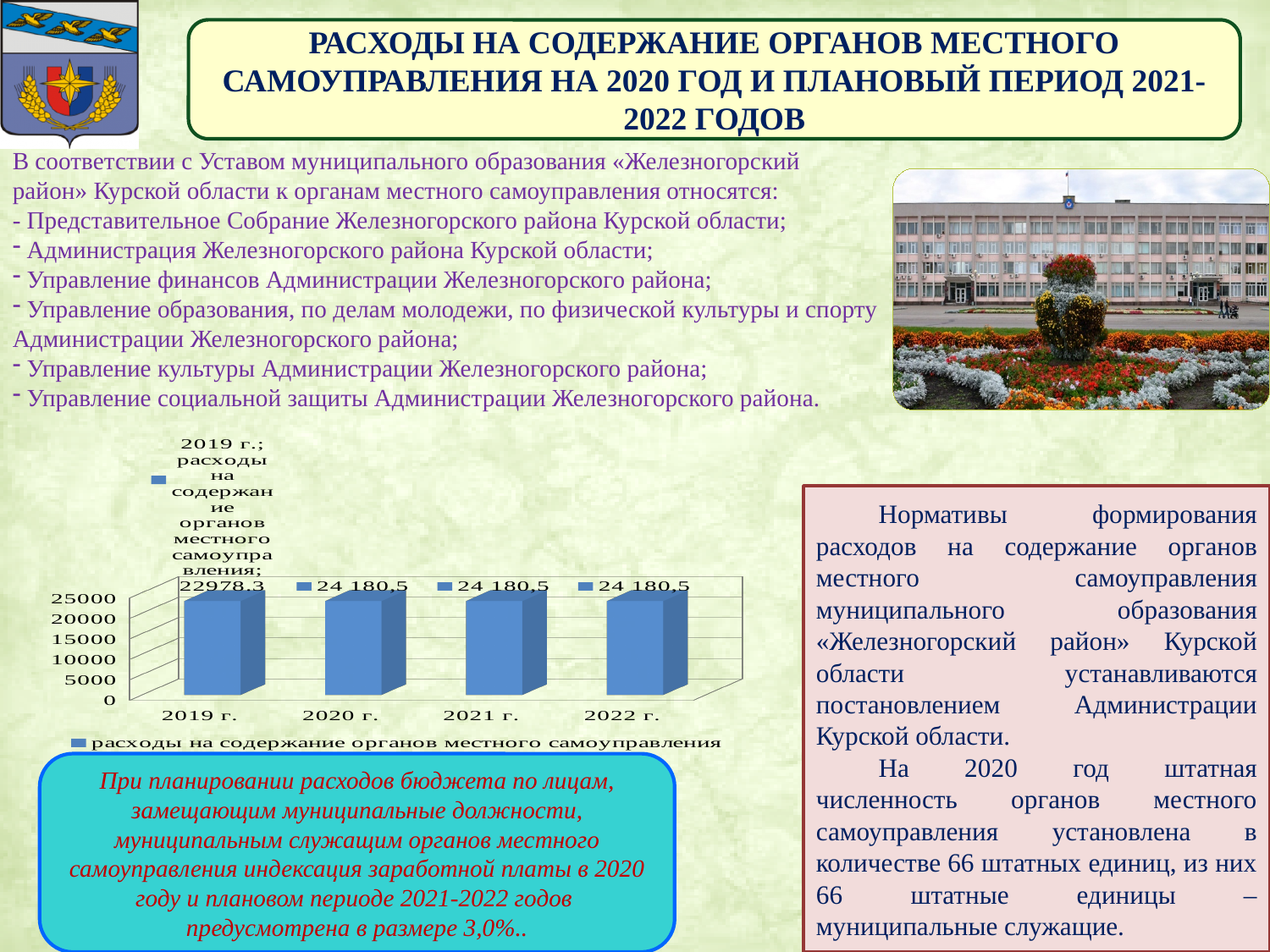
Which year has the lowest value in the chart? 2019 г. Do the values change between 2020 г. and 2022 г.? No, they stay the same What is the difference between the values for 2020 г. and 2019 г.? 1202,2 How many years are shown on the x axis of the chart? 4 What is the value for 2020 г. in the chart? 24 180,5 What is the value for 2022 г. in the chart? 24 180,5 What is the value for 2019 г. in the chart? 22978,3 What is the legend entry of the chart? расходы на содержание органов местного самоуправления What kind of chart is shown on the slide? bar chart How many series does the chart legend list? 1 Which is larger, the value for 2019 г. or the value for 2021 г.? 2021 г. Is the value for 2019 г. greater or less than 20000? greater